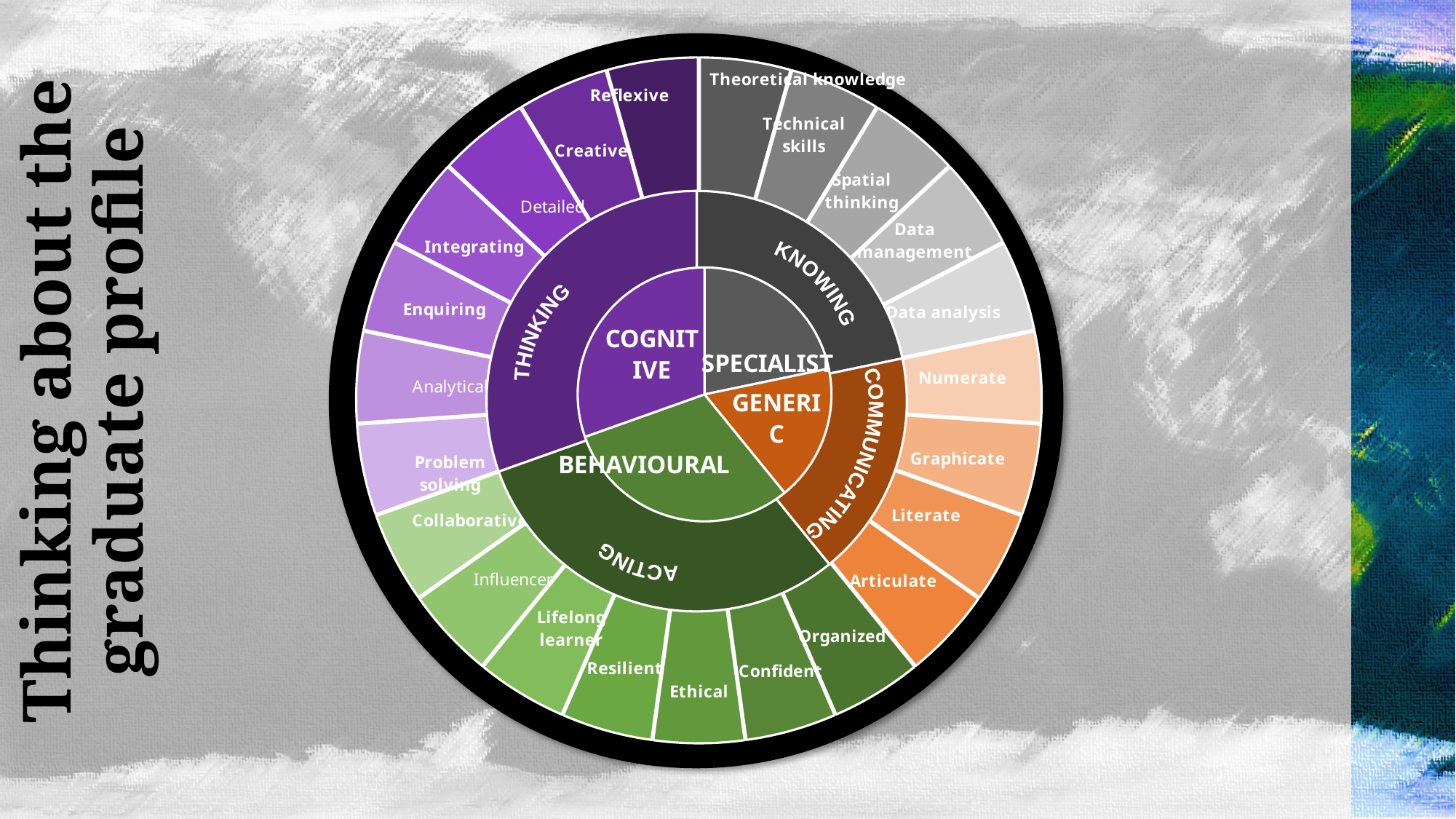
Which inner-ring category does the middle-ring segment 'THINKING' belong to? COGNITIVE How many outer-ring segments sit under the THINKING section? 7 Which middle-ring category does the outer segment 'Spatial thinking' belong to? KNOWING How many outer-ring segments sit under the KNOWING section? 5 How many outer-ring segments sit under the ACTING section? 7 What colour is used for the SPECIALIST section of the chart? Grey What kind of chart is shown on the slide? Sunburst chart Which middle-ring category does the outer segment 'Numerate' belong to? COMMUNICATING Which inner-ring category does the middle-ring segment 'ACTING' belong to? BEHAVIOURAL What colour is used for the BEHAVIOURAL section of the chart? Green